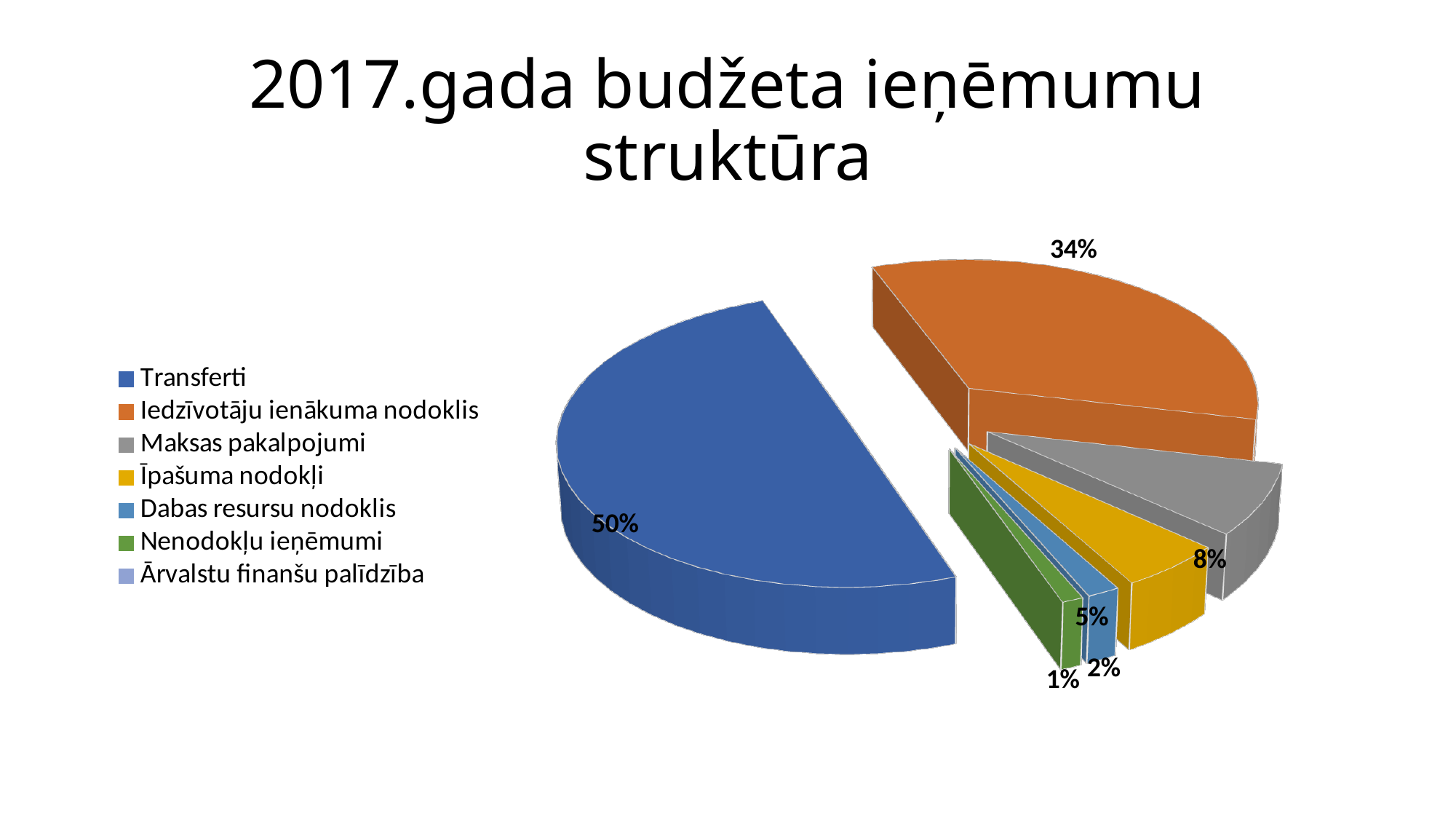
What is the difference between the share for Transferti and the share for Iedzīvotāju ienākuma nodoklis? 16% What share of the pie does Transferti have? 50% What share of the pie does Iedzīvotāju ienākuma nodoklis have? 34% What kind of chart is shown on the slide? pie chart What share of the pie does Nenodokļu ieņēmumi have? 1% Which category has the largest share of the pie? Transferti Which is larger, the share for Maksas pakalpojumi or the share for Īpašuma nodokļi? Maksas pakalpojumi How many categories does the legend list? 7 What is the title of the chart? 2017.gada budžeta ieņēmumu struktūra